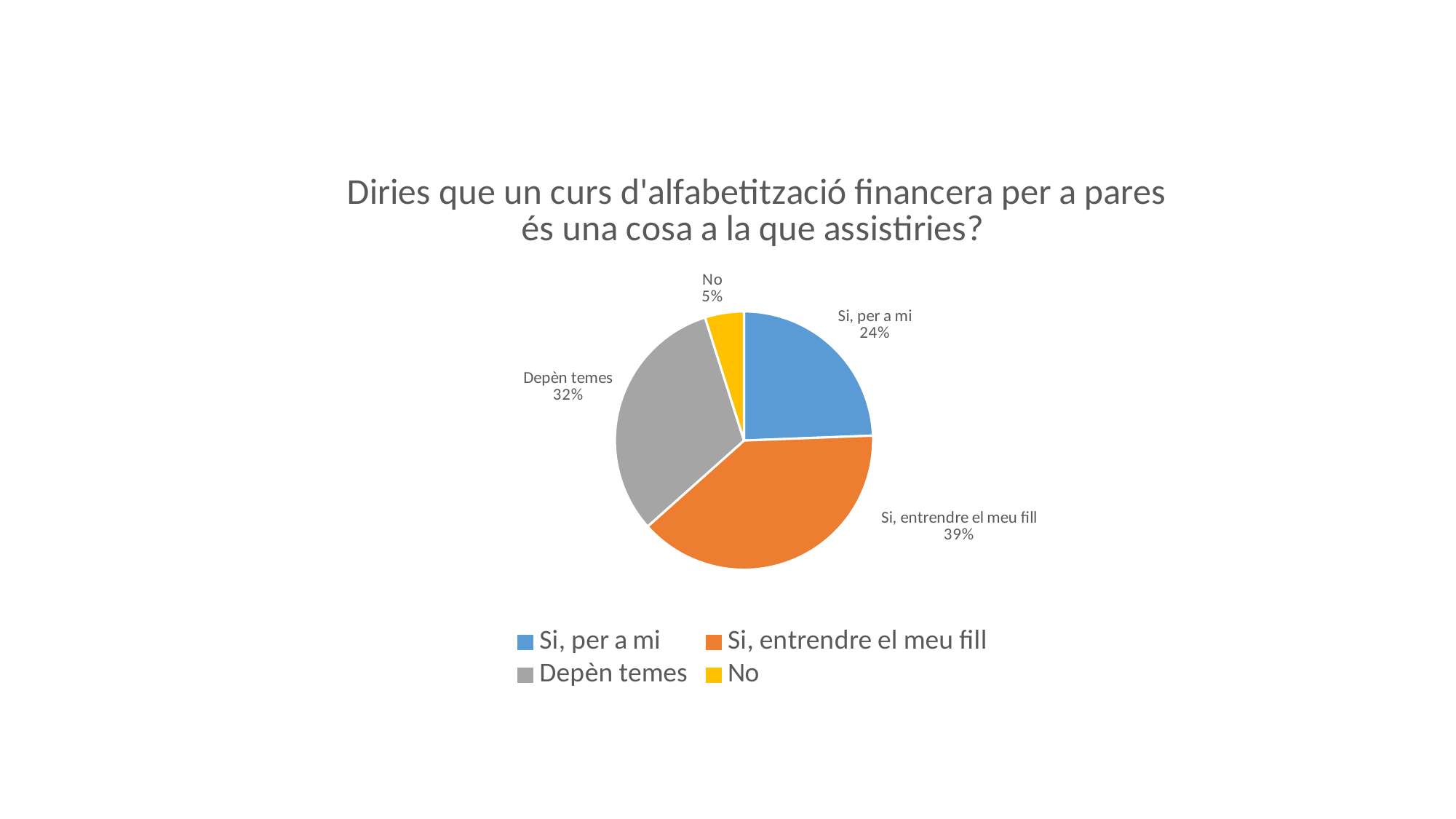
What share of the pie is labelled "Si, entrendre el meu fill"? 39% Which category has the largest slice of the pie? Si, entrendre el meu fill What share of the pie is labelled "Si, per a mi"? 24% What is the difference in percentage points between "Si, entrendre el meu fill" and "Si, per a mi"? 15 Which is larger, the slice for "Depèn temes" or the slice for "Si, per a mi"? Depèn temes What kind of chart is shown on the slide? Pie chart How many slices does the pie chart have? 4 What colour is the slice for "No"? Yellow How many entries does the legend list? 4 What share of the pie is labelled "Depèn temes"? 32% Which category has the smallest slice of the pie? No What share of the pie is labelled "No"? 5%